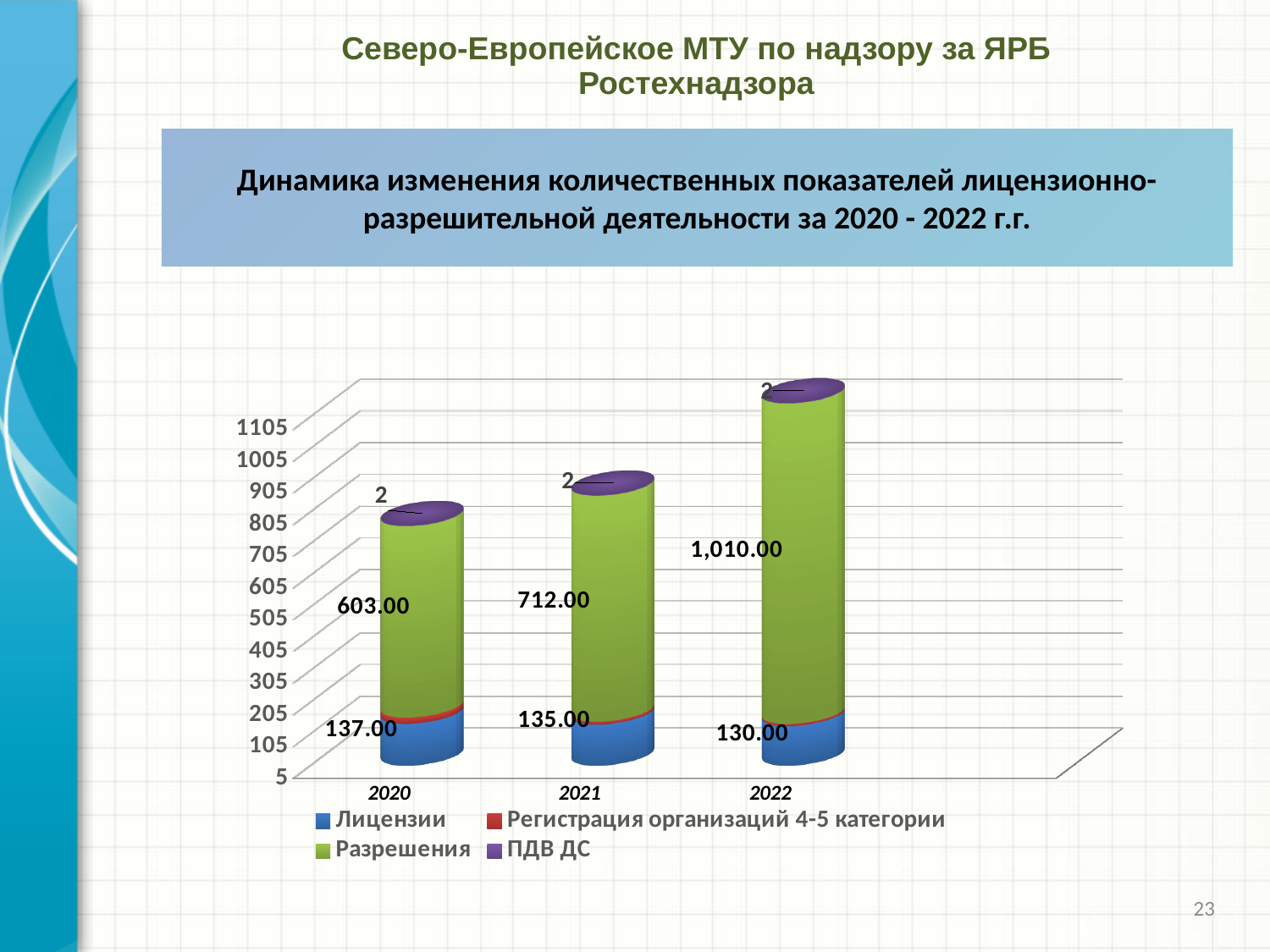
What is the value of Лицензии for 2020? 137.00 In which year is the value of Лицензии the lowest? 2022 What is the difference between the Лицензии values for 2020 and 2022? 7.00 What is the difference between the Разрешения values for 2022 and 2021? 298.00 How many years are shown on the x axis? 3 What is the value of Разрешения for 2022? 1,010.00 In which year is the value of Разрешения the highest? 2022 How many series does the legend list? 4 Which is larger: Разрешения in 2020 or Разрешения in 2021? Разрешения in 2021 What is the value of ПДВ ДС for 2021? 2 What is the value of Разрешения for 2021? 712.00 Does the value of Разрешения rise or fall from 2020 to 2022? rise